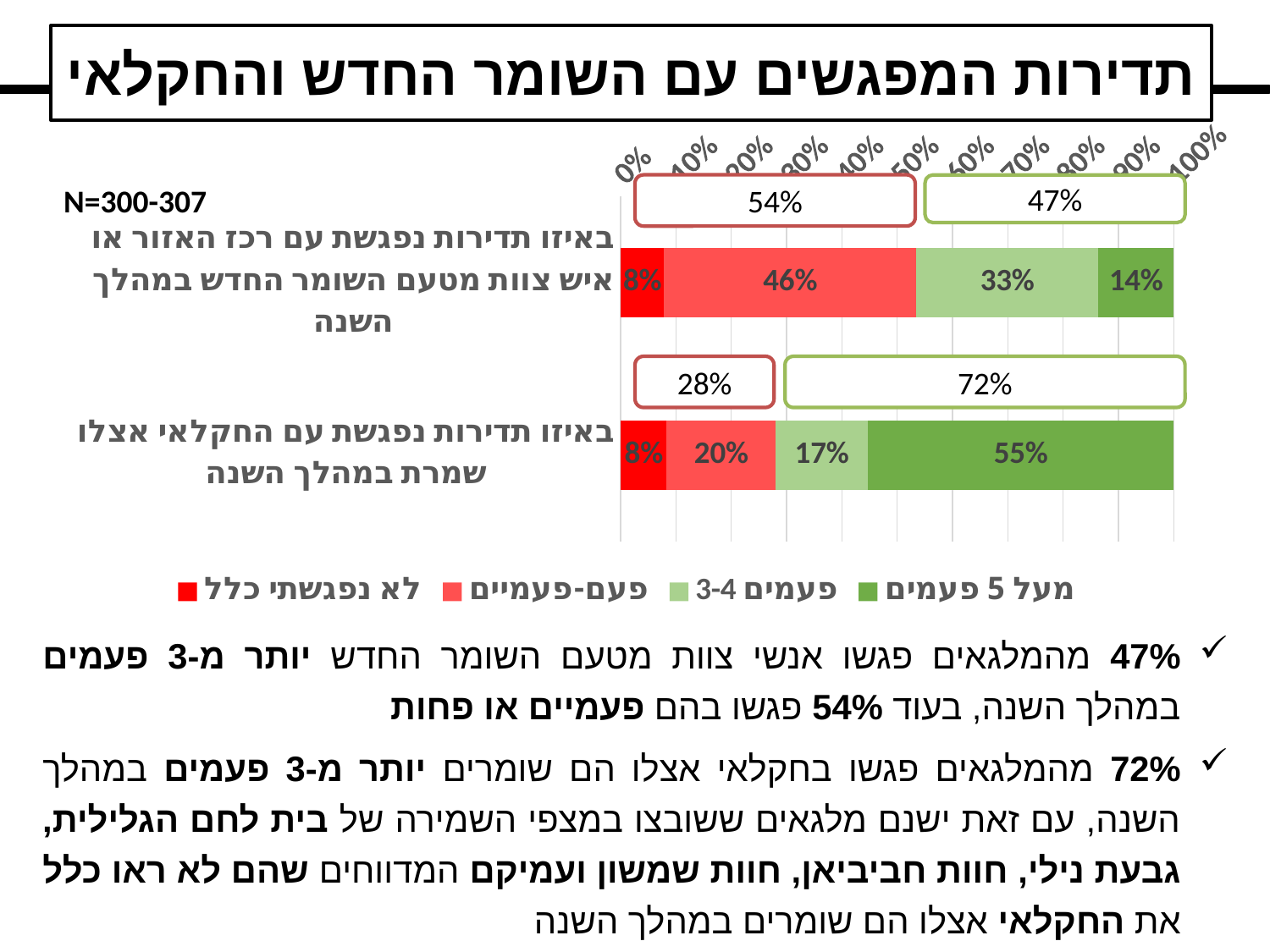
How many series does the legend list? 4 What is the difference between the 'מעל 5 פעמים' values for the farmer bar and the HaShomer HaChadash staff bar? 41% What is the value of the 'פעם-פעמיים' segment for the bar about meeting the regional coordinator or HaShomer HaChadash staff member (רכז האזור או איש צוות מטעם השומר החדש)? 46% Which bar has the larger 'פעם-פעמיים' value: the HaShomer HaChadash staff bar or the farmer bar? The HaShomer HaChadash staff bar Which segment is the smallest in the bar about meeting the regional coordinator or HaShomer HaChadash staff member? לא נפגשתי כלל What kind of chart is shown on the slide? Stacked bar chart How many categories (bars) are plotted in the chart? 2 What is the value of the 'מעל 5 פעמים' segment for the bar about meeting the farmer (החקלאי אצלו שמרת)? 55% What sample size (N) is shown on the slide? N=300-307 Which segment is the largest in the bar about meeting the farmer (החקלאי אצלו שמרת)? מעל 5 פעמים What is the value of the 'לא נפגשתי כלל' segment for the bar about meeting the farmer? 8% What is the value of the '3-4 פעמים' segment for the bar about meeting the regional coordinator or HaShomer HaChadash staff member? 33%